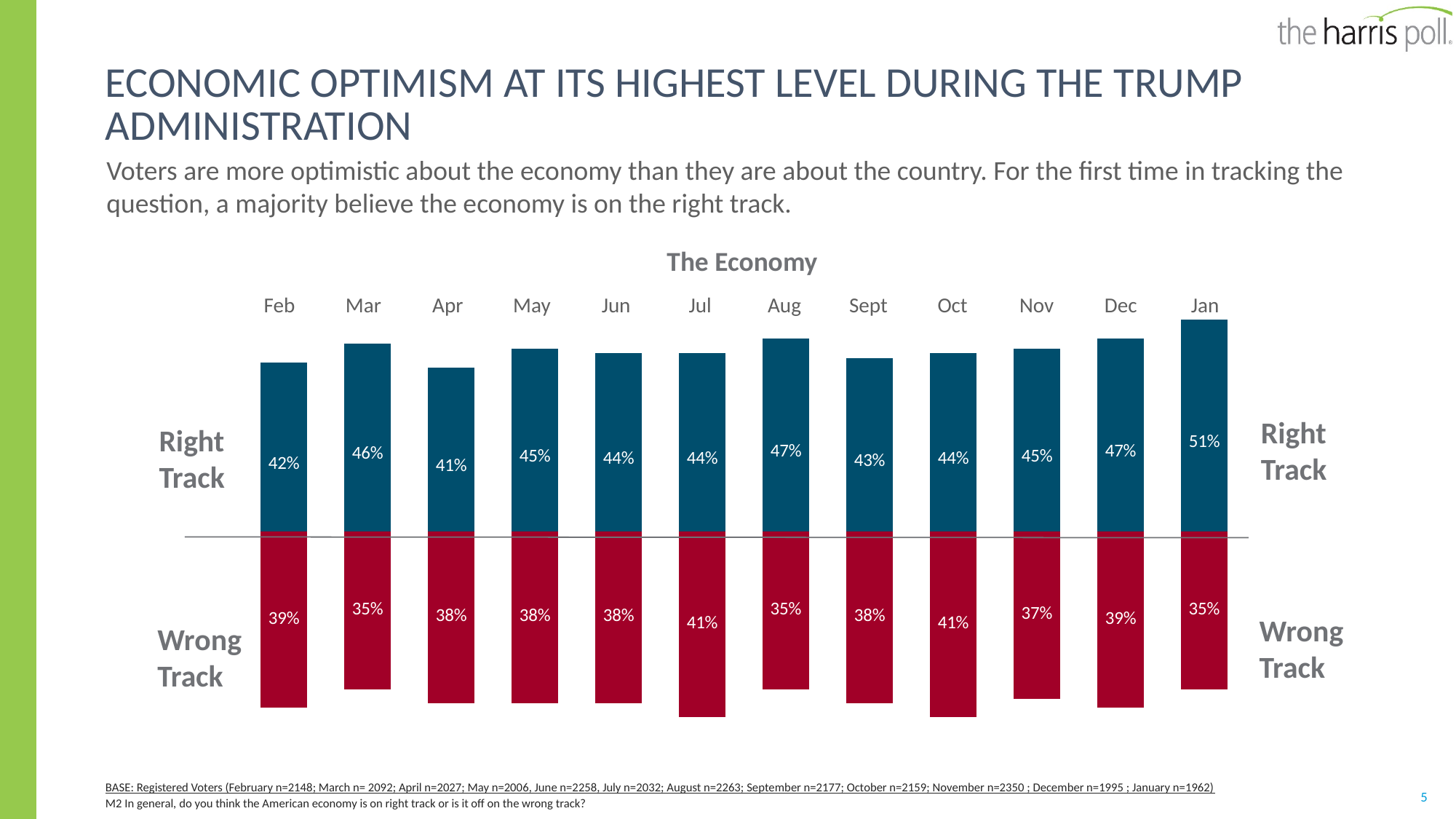
What kind of chart is shown on the slide? Bar chart What is the difference between the Right Track values for Mar and Feb? 4% What is the Right Track value for Apr? 41% What is the difference between the Right Track and Wrong Track values for Jan? 16% What is the Right Track value for Jan? 51% Which month has the lowest Right Track value? Apr Which is larger, the Wrong Track value for Oct or the Wrong Track value for Nov? Oct What is the title of the chart? The Economy What colour are the Wrong Track bars? Red How many months are shown on the chart? 12 What is the Wrong Track value for Jul? 41% Which month has the highest Right Track value? Jan